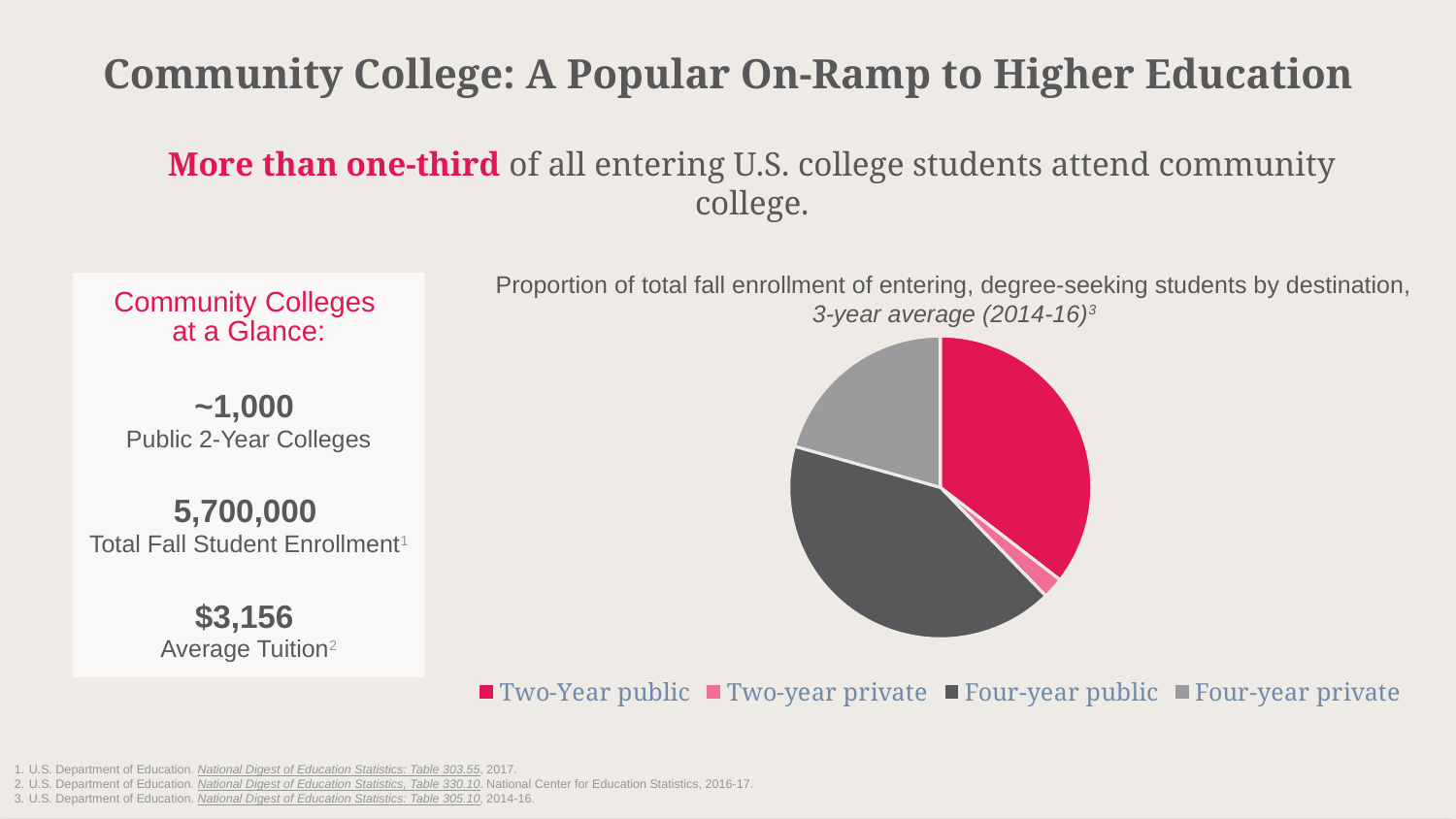
Which slice is larger in the pie chart: Two-Year public or Four-year private? Two-Year public Which slice is larger in the pie chart: Four-year private or Two-year private? Four-year private What kind of chart is shown on the slide? Pie chart Which destination has the smallest slice of the pie chart? Two-year private What is the title of the pie chart? Proportion of total fall enrollment of entering, degree-seeking students by destination, 3-year average (2014-16) Which destination has the largest slice of the pie chart? Four-year public How many slices does the pie chart have? 4 Which legend entry of the pie chart is shown in red? Two-Year public Which slice is larger in the pie chart: Four-year public or Two-year private? Four-year public How many entries does the legend of the pie chart list? 4